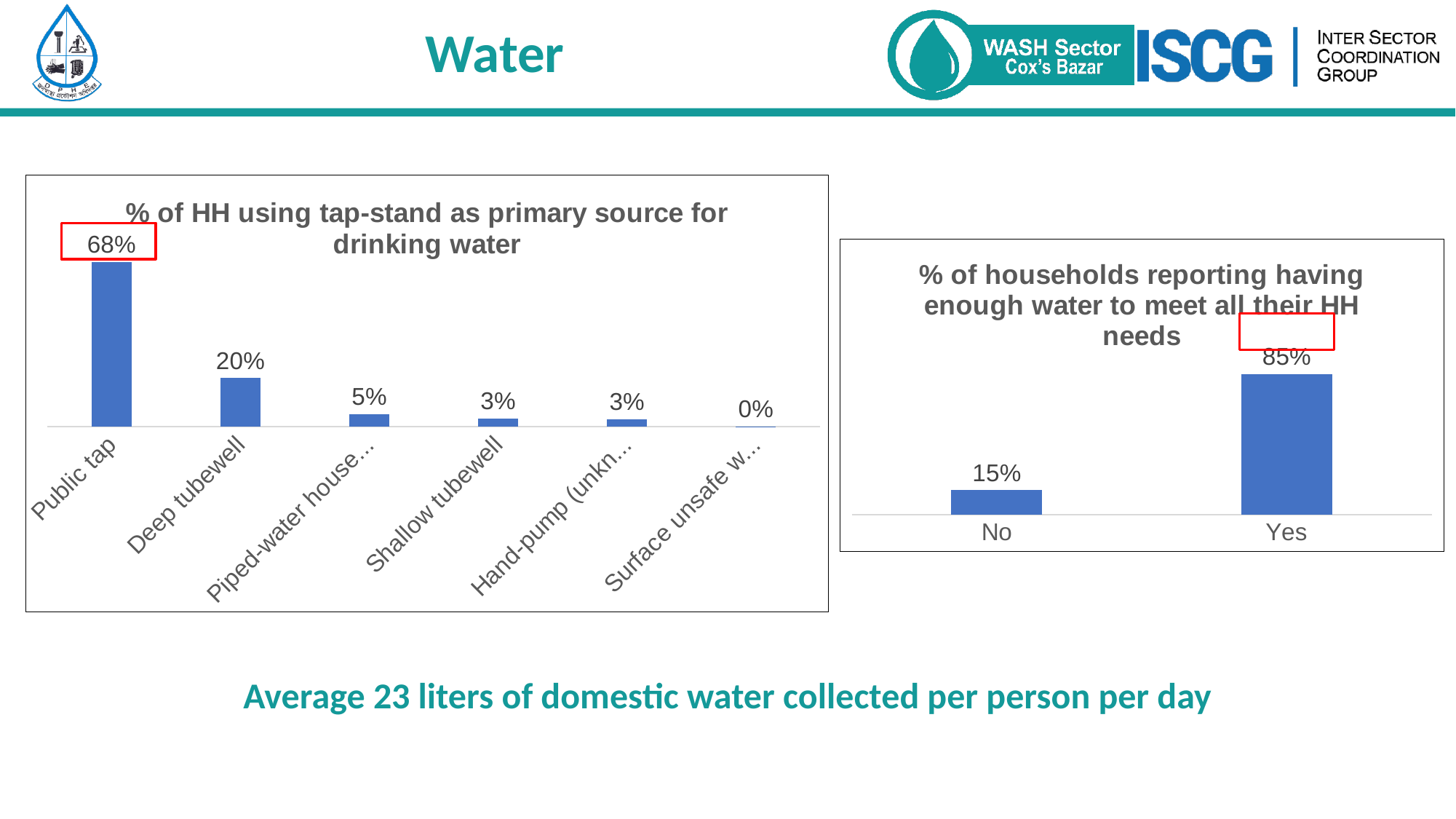
In the left chart (% of HH using tap-stand as primary source for drinking water), how many categories are shown? 6 In the right chart (% of households reporting having enough water to meet all their HH needs), what is the value for Yes? 85% In the left chart (% of HH using tap-stand as primary source for drinking water), do the values rise or fall from left to right? fall In the left chart (% of HH using tap-stand as primary source for drinking water), what is the value for Deep tubewell? 20% In the right chart (% of households reporting having enough water to meet all their HH needs), what is the difference between the Yes and No values? 70% In the right chart (% of households reporting having enough water to meet all their HH needs), what is the value for No? 15% In the left chart (% of HH using tap-stand as primary source for drinking water), which category has the highest value? Public tap In the right chart (% of households reporting having enough water to meet all their HH needs), which is larger, Yes or No? Yes In the left chart (% of HH using tap-stand as primary source for drinking water), what is the difference between the Public tap and Deep tubewell values? 48% What type of chart is the right chart (% of households reporting having enough water to meet all their HH needs)? bar chart In the left chart (% of HH using tap-stand as primary source for drinking water), what is the value for Public tap? 68% In the left chart (% of HH using tap-stand as primary source for drinking water), what is the value for Shallow tubewell? 3%